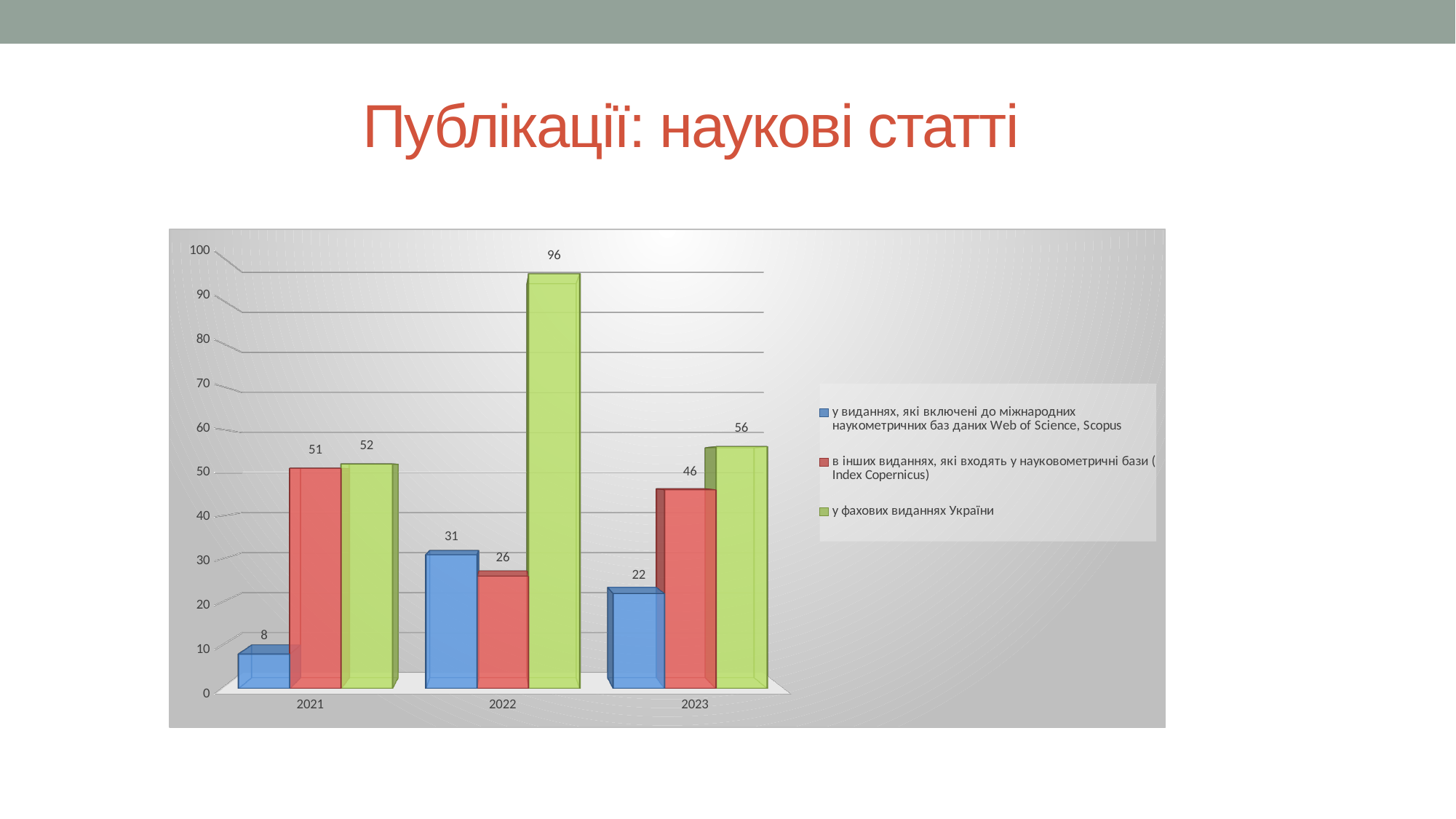
What is the title of the slide? Публікації: наукові статті What kind of chart is shown on the slide? Bar chart What is the value for 2022 in the series "у фахових виданнях України"? 96 Which year has the lowest value in the series "у виданнях, які включені до міжнародних наукометричних баз даних Web of Science, Scopus"? 2021 What is the value for 2023 in the series "в інших виданнях, які входять у науковометричні бази (Index Copernicus)"? 46 What is the value for 2021 in the series "у виданнях, які включені до міжнародних наукометричних баз даних Web of Science, Scopus"? 8 Which year has the highest value in the series "у фахових виданнях України"? 2022 What is the difference between the 2022 and 2023 values in the series "у фахових виданнях України"? 40 How many years are shown on the x axis? 3 Is the value for 2022 in the series "у фахових виданнях України" greater or less than 90? greater How many series does the legend list? 3 Which is larger for 2022: the Web of Science, Scopus series or the Index Copernicus series? Web of Science, Scopus series